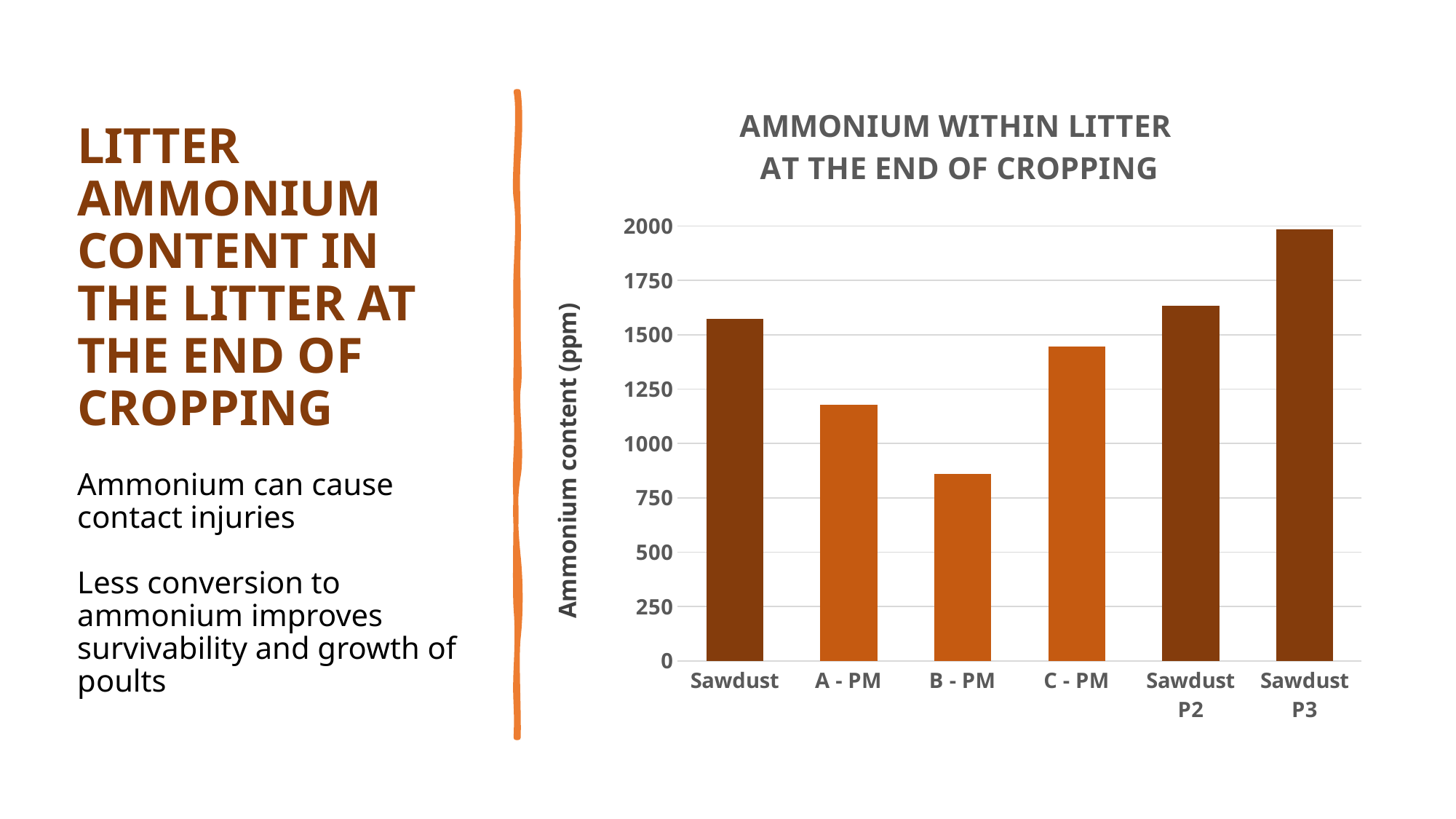
Is the value for A - PM greater or less than 1250? less Is the value for B - PM greater or less than 750? greater Which category has the highest ammonium content? Sawdust P3 How many categories are shown on the x axis of the chart? 6 What kind of chart is shown on the slide? bar chart Is the value for Sawdust greater or less than 1500? greater Which has a higher ammonium content, C - PM or Sawdust P2? Sawdust P2 Which category has the lowest ammonium content? B - PM What is the label of the vertical axis of the chart? Ammonium content (ppm) Which has a higher ammonium content, Sawdust or A - PM? Sawdust